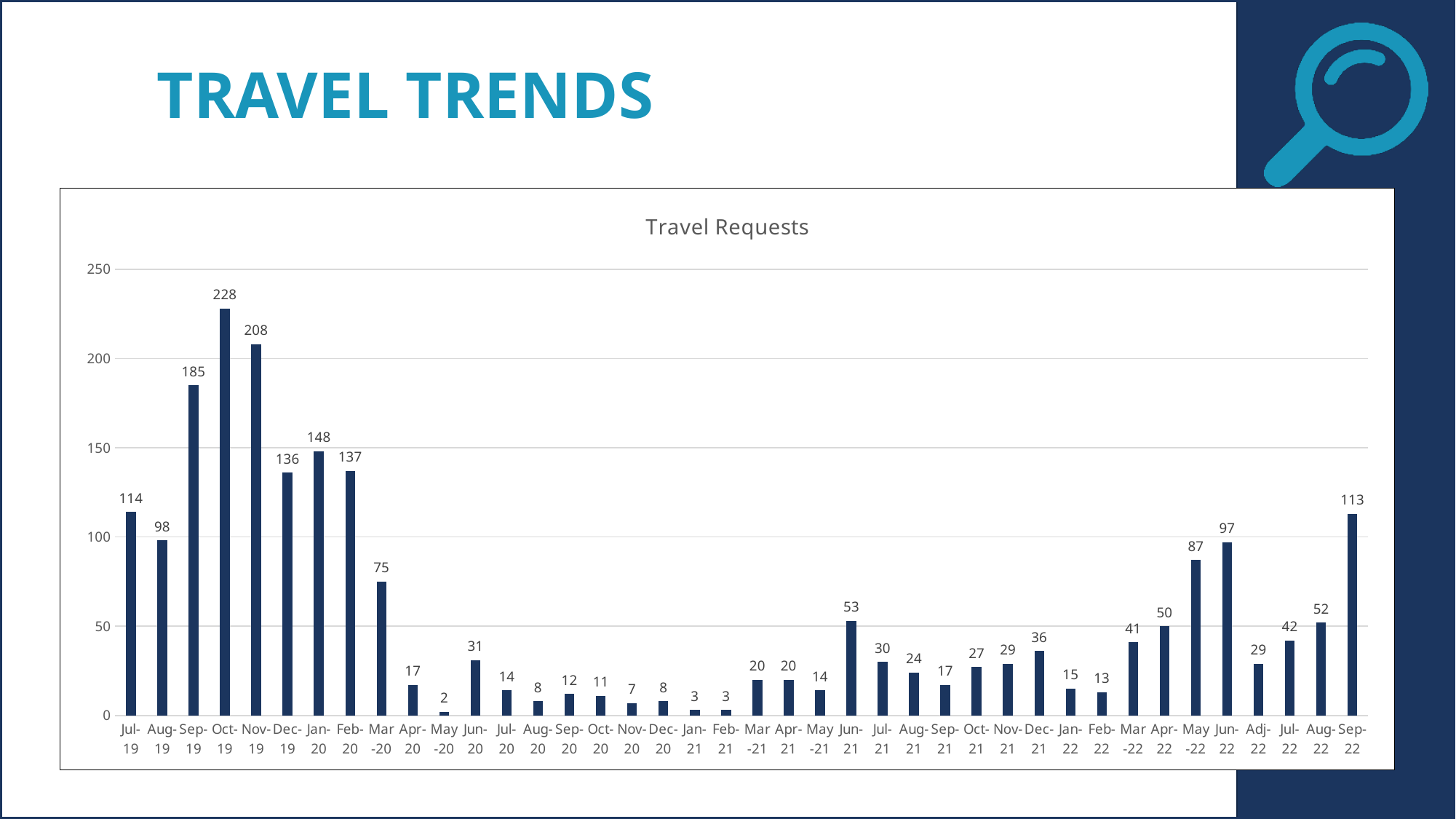
Which month has the highest number of travel requests? Oct-19 Which is larger, the value for Jul-19 or the value for Sep-22? Jul-19 What kind of chart is used to show Travel Requests? bar chart Which month has the lowest number of travel requests? May-20 Is the value for Sep-19 greater or less than 150? greater What is the difference between the travel requests for Jun-22 and May-22? 10 What is the value for Oct-19 in the Travel Requests chart? 228 How many months are shown on the x axis of the Travel Requests chart? 40 What is the difference between the travel requests for Oct-19 and Nov-19? 20 What is the value for Sep-22 in the Travel Requests chart? 113 What is the value for Mar-20 in the Travel Requests chart? 75 What is the title of the chart on the slide? Travel Requests